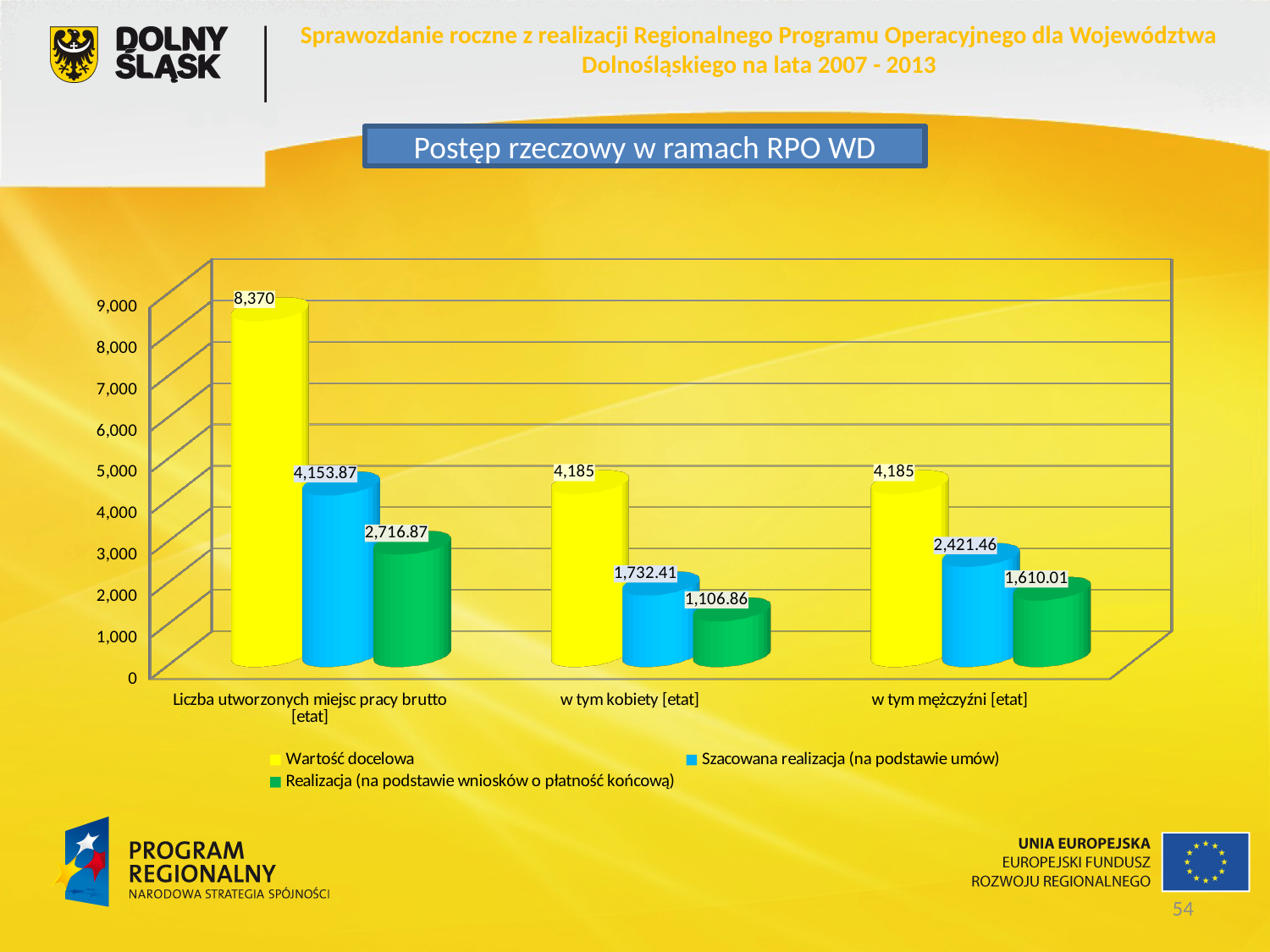
Which is larger: the Realizacja (na podstawie wniosków o płatność końcową) value for w tym mężczyźni [etat] or for w tym kobiety [etat]? w tym mężczyźni [etat] How many series does the legend list? 3 Which category has the highest Wartość docelowa value? Liczba utworzonych miejsc pracy brutto [etat] What kind of chart is shown on the slide? Bar chart What is the Realizacja (na podstawie wniosków o płatność końcową) value for w tym mężczyźni [etat]? 1,610.01 Which category has the lowest Realizacja (na podstawie wniosków o płatność końcową) value? w tym kobiety [etat] What is the Wartość docelowa value for Liczba utworzonych miejsc pracy brutto [etat]? 8,370 What is the difference between the Wartość docelowa and Szacowana realizacja (na podstawie umów) values for Liczba utworzonych miejsc pracy brutto [etat]? 4,216.13 How many categories are shown on the x axis? 3 What is the Szacowana realizacja (na podstawie umów) value for w tym kobiety [etat]? 1,732.41 What is the Szacowana realizacja (na podstawie umów) value for w tym mężczyźni [etat]? 2,421.46 What is the difference between the Szacowana realizacja (na podstawie umów) values for w tym mężczyźni [etat] and w tym kobiety [etat]? 689.05